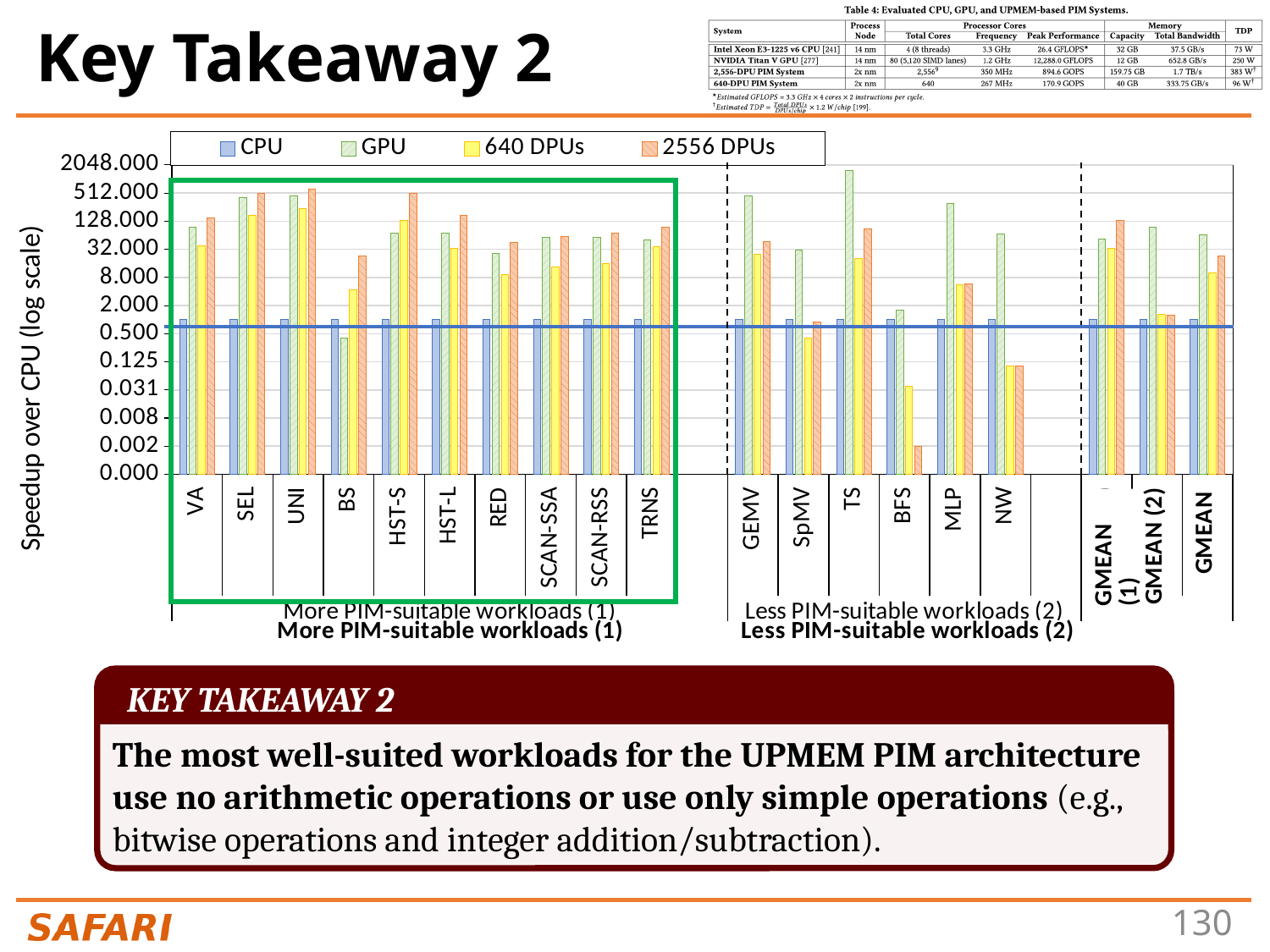
Is the GPU value for TS greater or less than 512? greater How many workload categories are shown along the x axis of the chart? 19 For BS, which is larger: the GPU value or the 2556 DPUs value? 2556 DPUs Which series are listed in the chart legend? CPU, GPU, 640 DPUs, 2556 DPUs Is the 2556 DPUs value for BFS greater or less than 0.031? less What kind of chart is shown on the slide? bar chart What is the label of the y axis of the chart? Speedup over CPU (log scale) Which workload has the highest GPU bar? TS Which workload has the lowest 2556 DPUs bar? BFS For GEMV, which is larger: the GPU value or the 2556 DPUs value? GPU Is the 2556 DPUs value for UNI greater or less than 128? greater How many series does the chart legend list? 4